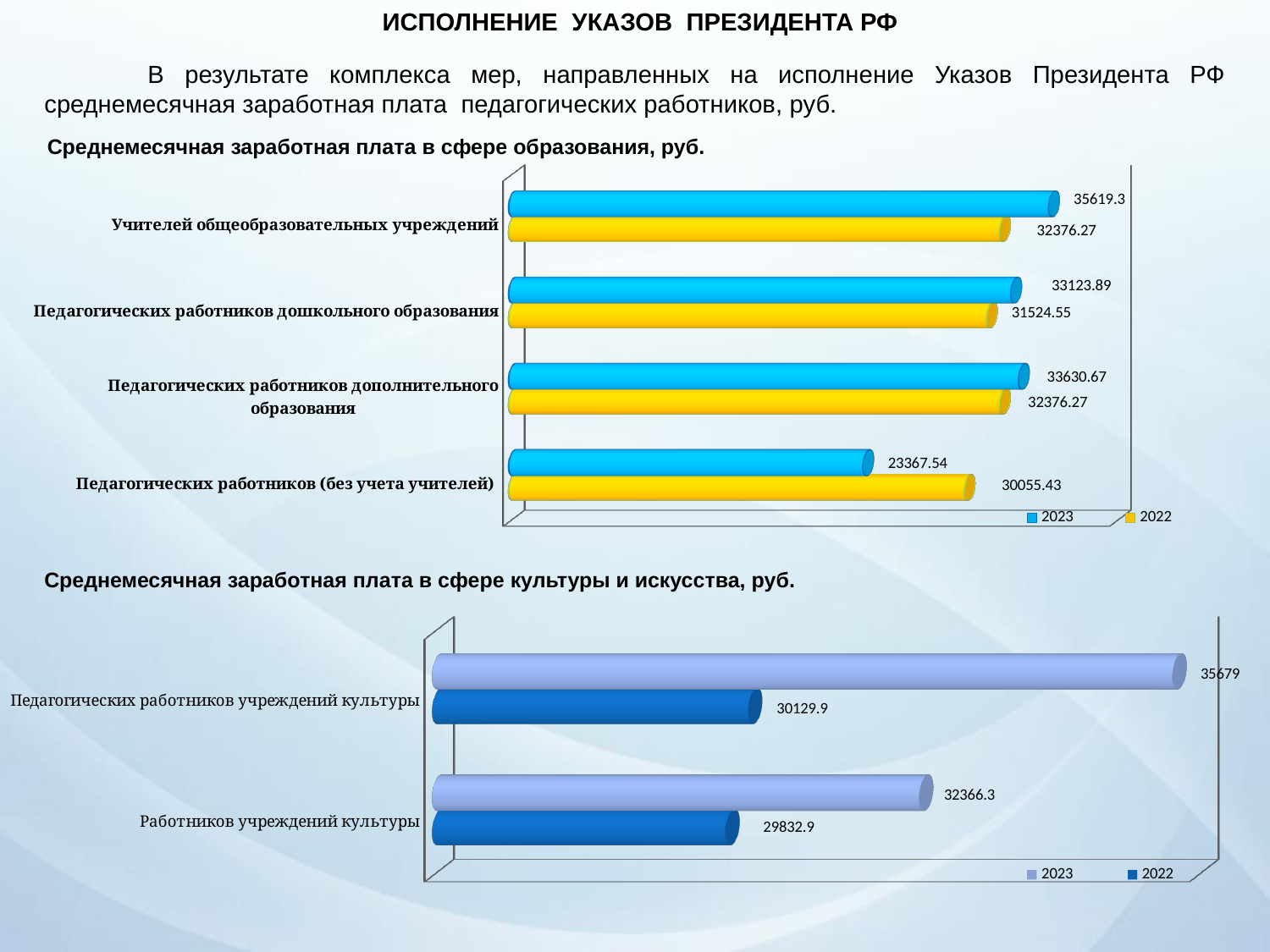
In the chart 'Среднемесячная заработная плата в сфере образования, руб.', what is the difference between the 2023 and 2022 values for 'Учителей общеобразовательных учреждений'? 3243.03 In the chart 'Среднемесячная заработная плата в сфере образования, руб.', for 'Педагогических работников (без учета учителей)', which year has the larger value, 2023 or 2022? 2022 How many series does the legend list in the chart 'Среднемесячная заработная плата в сфере культуры и искусства, руб.'? 2 In the chart 'Среднемесячная заработная плата в сфере культуры и искусства, руб.', what is the 2022 value for 'Работников учреждений культуры'? 29832.9 How many categories are shown in the chart 'Среднемесячная заработная плата в сфере образования, руб.'? 4 In the chart 'Среднемесячная заработная плата в сфере образования, руб.', what is the 2023 value for 'Учителей общеобразовательных учреждений'? 35619.3 In the chart 'Среднемесячная заработная плата в сфере образования, руб.', which category has the highest 2023 value? Учителей общеобразовательных учреждений In the chart 'Среднемесячная заработная плата в сфере культуры и искусства, руб.', what is the 2023 value for 'Педагогических работников учреждений культуры'? 35679 In the chart 'Среднемесячная заработная плата в сфере образования, руб.', what is the 2022 value for 'Педагогических работников дошкольного образования'? 31524.55 What type of chart is 'Среднемесячная заработная плата в сфере культуры и искусства, руб.'? Bar chart In the chart 'Среднемесячная заработная плата в сфере образования, руб.', which category has the lowest 2023 value? Педагогических работников (без учета учителей) In the chart 'Среднемесячная заработная плата в сфере культуры и искусства, руб.', what is the difference between the 2023 and 2022 values for 'Педагогических работников учреждений культуры'? 5549.1